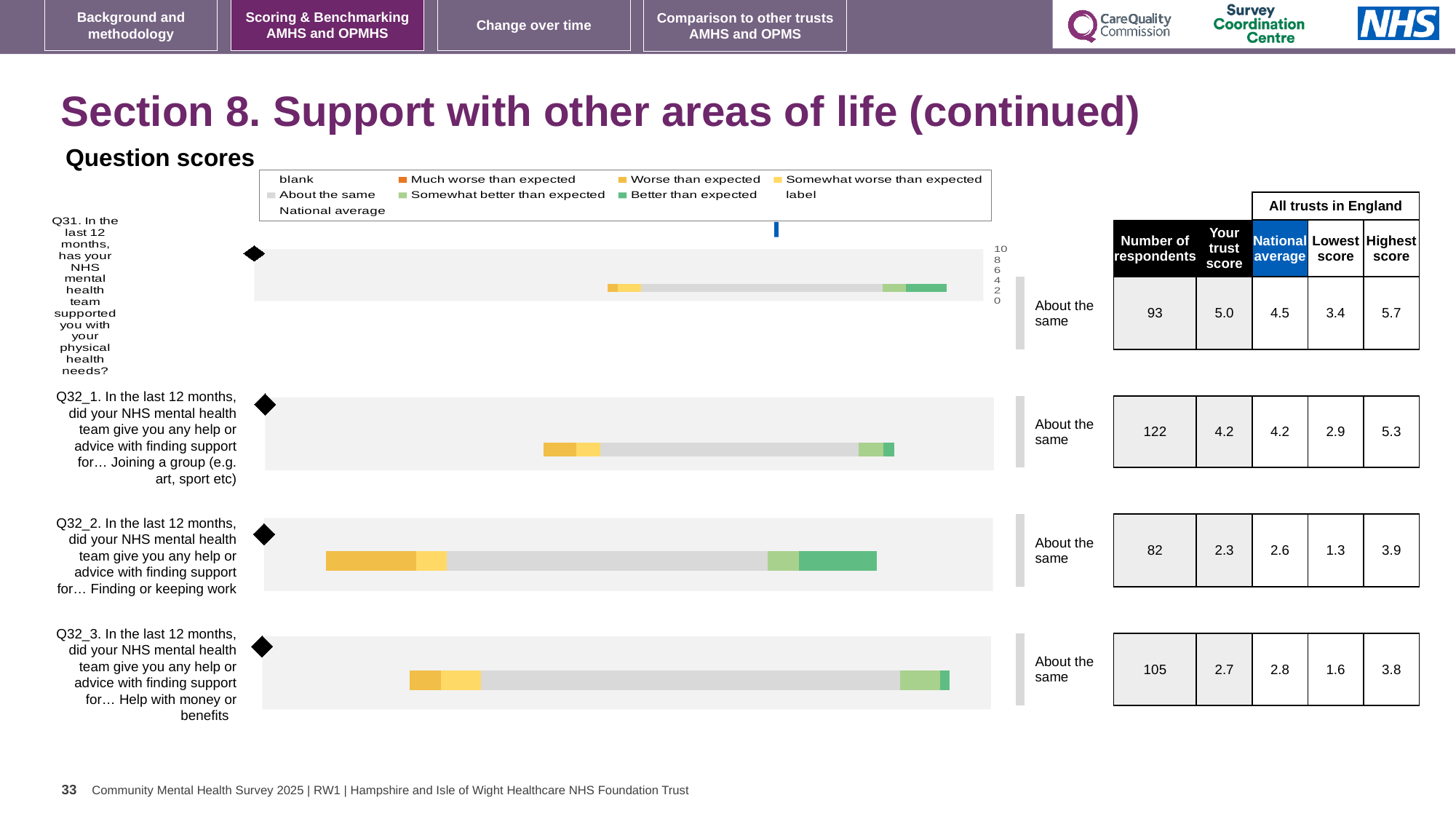
What is the national average for Q32_2 (finding or keeping work)? 2.6 For Q31, what is the difference between the highest score and the lowest score across all trusts in England? 2.3 What is the 'Your trust score' value for Q31 (support with physical health needs)? 5.0 How many questions (bar charts) are shown on the slide? 4 How many respondents answered Q32_1 (joining a group)? 122 What kind of chart is used to show the question scores on this slide? bar chart For Q32_2, how much lower is the trust score than the national average? 0.3 Which legend entry is shown in orange? Much worse than expected For Q32_3 (help with money or benefits), which is larger: the trust score or the national average? National average Which question has the highest 'Your trust score'? Q31 Which question has the lowest 'Your trust score'? Q32_2 What comparison label is shown next to each of the four bar charts? About the same